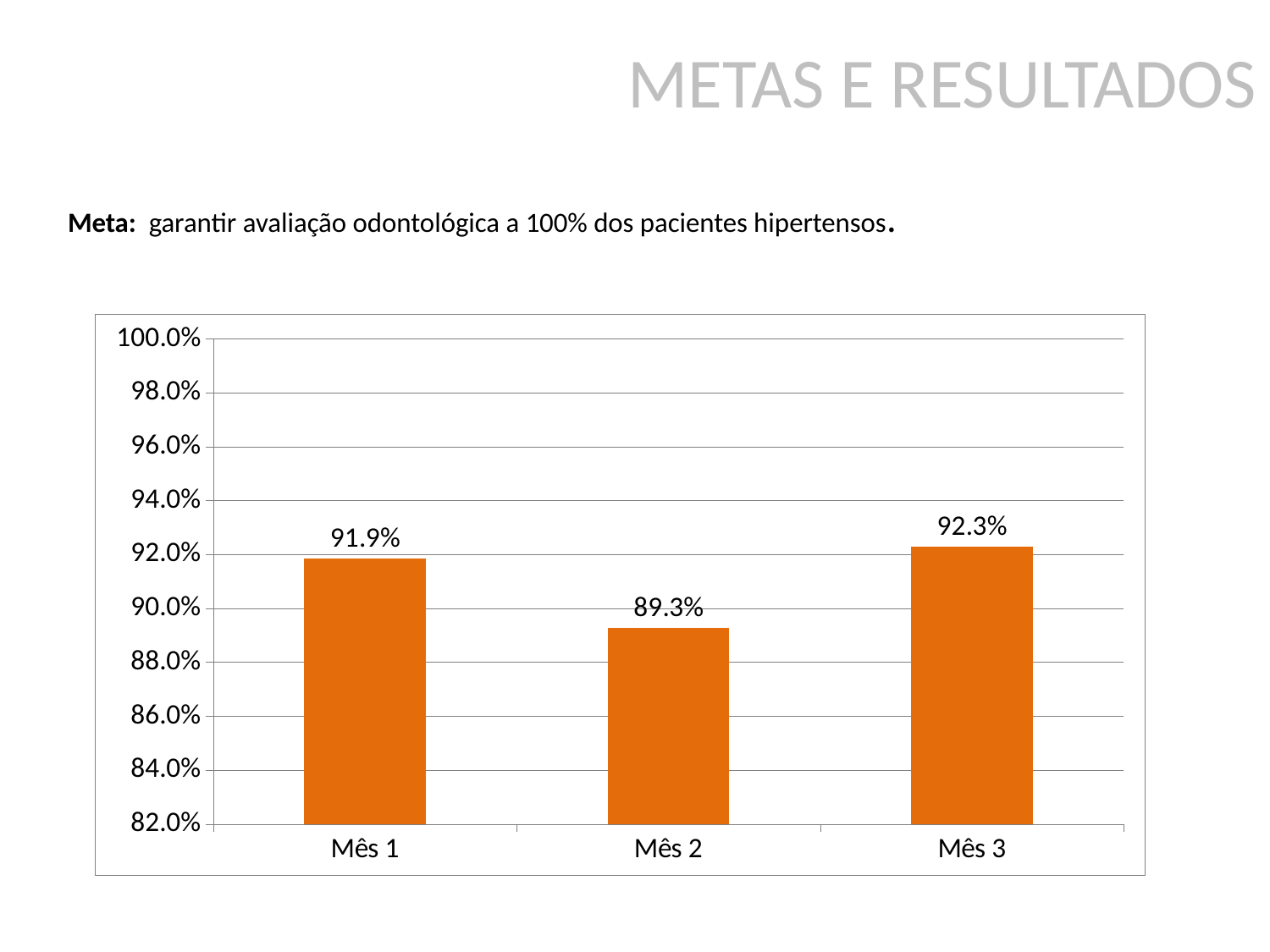
What is the value for Mês 2? 89.3% What is the value for Mês 1? 91.9% Which month has the highest value? Mês 3 What is the difference between the values for Mês 3 and Mês 2? 3.0% What kind of chart is shown on the slide? bar chart What is the lowest value shown on the vertical axis? 82.0% Which is larger, the value for Mês 1 or the value for Mês 2? Mês 1 How many months are shown on the chart? 3 Is the value for Mês 2 greater or less than 90.0%? less What is the value for Mês 3? 92.3% What is the difference between the values for Mês 1 and Mês 2? 2.6% Which month has the lowest value? Mês 2